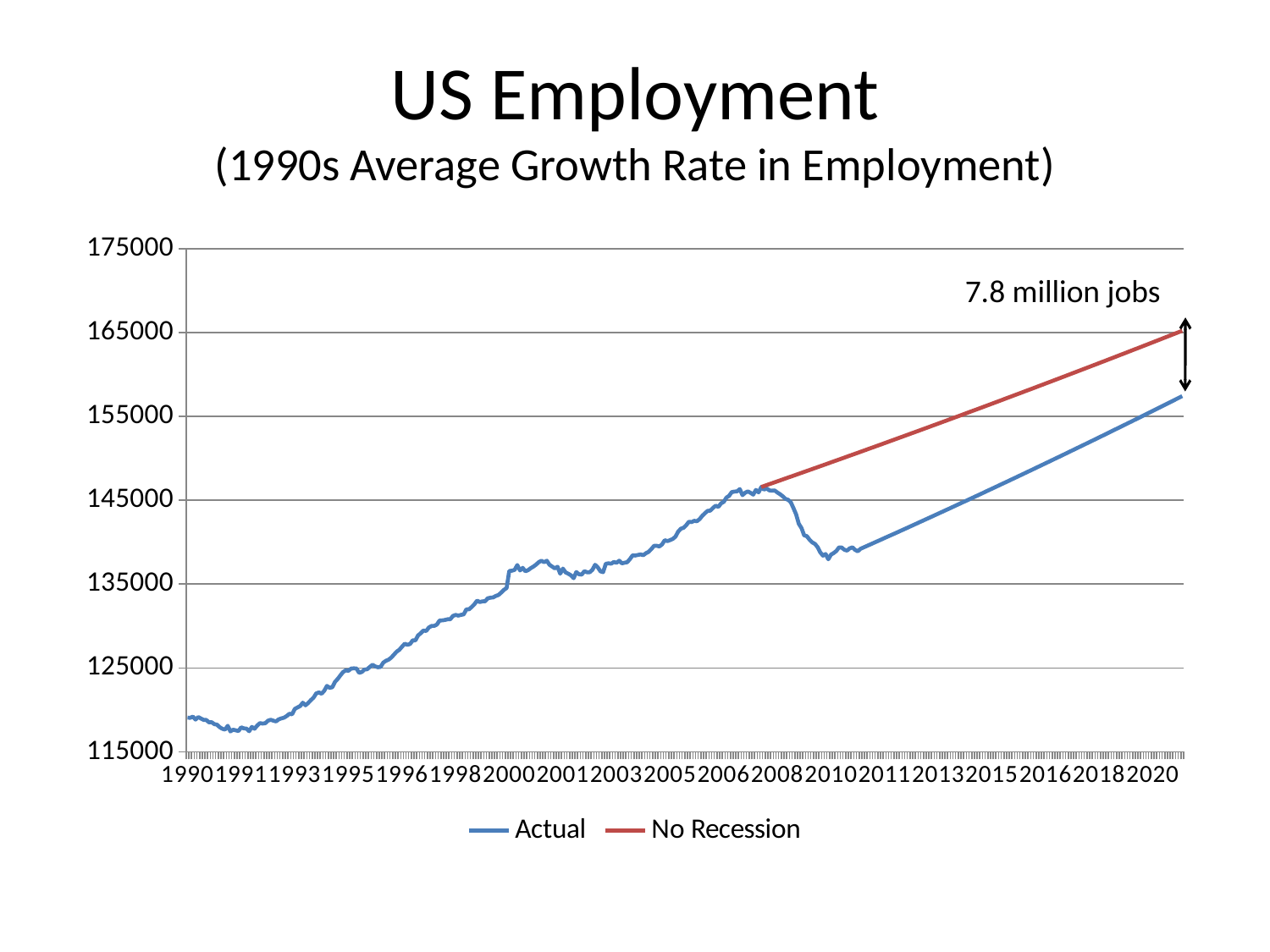
Is the value of the Actual series at 2020 greater or less than 155000? greater What are the two series named in the legend? Actual and No Recession Is the value of the No Recession series at 2020 greater or less than 155000? greater Is the value of the Actual series in 1990 greater or less than 125000? less Which series is drawn in red? No Recession What kind of chart is shown on the slide? line chart How many series does the legend list? 2 At 2020, which series is higher, Actual or No Recession? No Recession According to the annotation, how large is the gap between the No Recession and Actual lines at the end of the chart? 7.8 million jobs Does the Actual series rise or fall between 1990 and 2000? rise